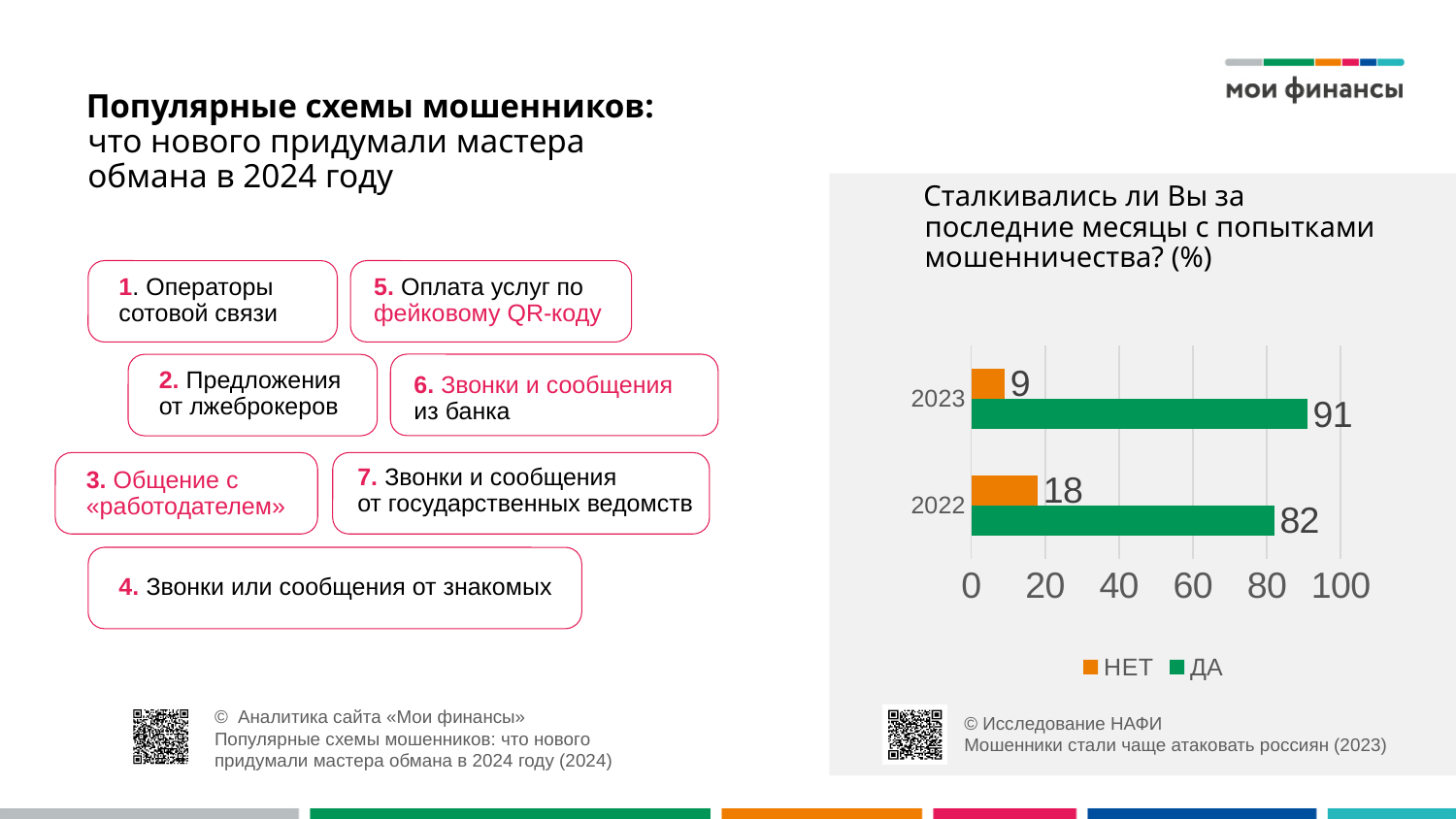
What is the value for ДА in 2023? 91 What type of chart is shown on the slide? bar chart Which is larger: НЕТ in 2022 or НЕТ in 2023? НЕТ in 2022 What is the value for ДА in 2022? 82 What is the difference between the НЕТ values for 2022 and 2023? 9 In which year is the НЕТ value lowest? 2023 What is the value for НЕТ in 2023? 9 How many series does the legend list? 2 What is the title of the chart? Сталкивались ли Вы за последние месяцы с попытками мошенничества? (%) In which year is the ДА value higher? 2023 What is the difference between the ДА values for 2023 and 2022? 9 What is the value for НЕТ in 2022? 18